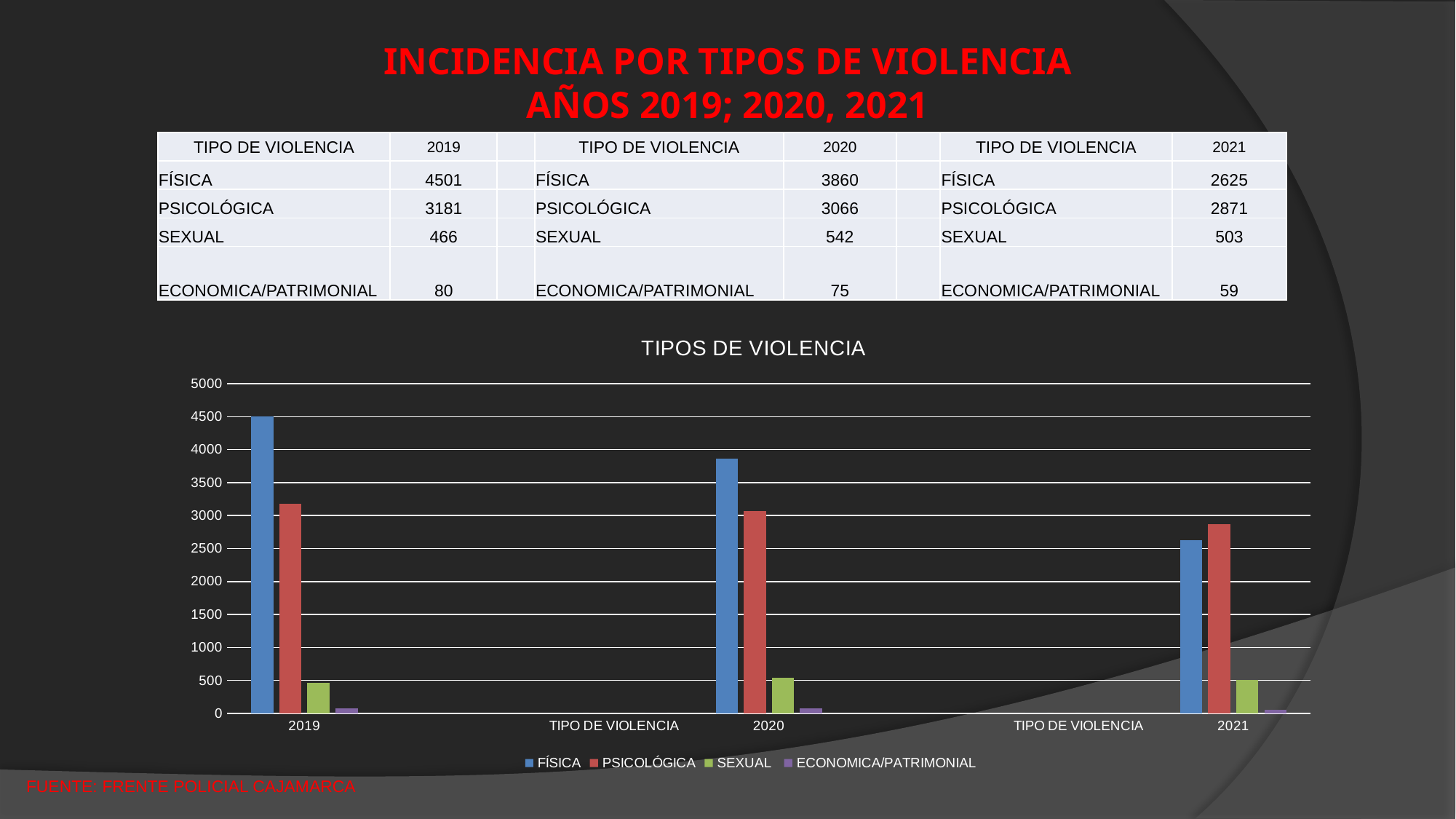
In the TIPOS DE VIOLENCIA chart, what is the value for SEXUAL in 2020? 542 In the TIPOS DE VIOLENCIA chart, which type of violence has the lowest value in 2019? ECONOMICA/PATRIMONIAL How many series does the legend of the TIPOS DE VIOLENCIA chart list? 4 In the TIPOS DE VIOLENCIA chart, what is the value for ECONOMICA/PATRIMONIAL in 2021? 59 In the TIPOS DE VIOLENCIA chart, by how much did the FÍSICA value decrease from 2019 to 2021? 1876 In the TIPOS DE VIOLENCIA chart, does the FÍSICA value rise or fall from 2019 to 2021? fall In the TIPOS DE VIOLENCIA chart, what is the value for FÍSICA in 2019? 4501 In the TIPOS DE VIOLENCIA chart, is the value for FÍSICA in 2020 greater or less than 3500? greater What is the title of the chart on the slide? TIPOS DE VIOLENCIA In the TIPOS DE VIOLENCIA chart, which is larger in 2020: FÍSICA or PSICOLÓGICA? FÍSICA In the TIPOS DE VIOLENCIA chart, which type of violence has the highest value in 2021? PSICOLÓGICA What kind of chart is the TIPOS DE VIOLENCIA chart? bar chart